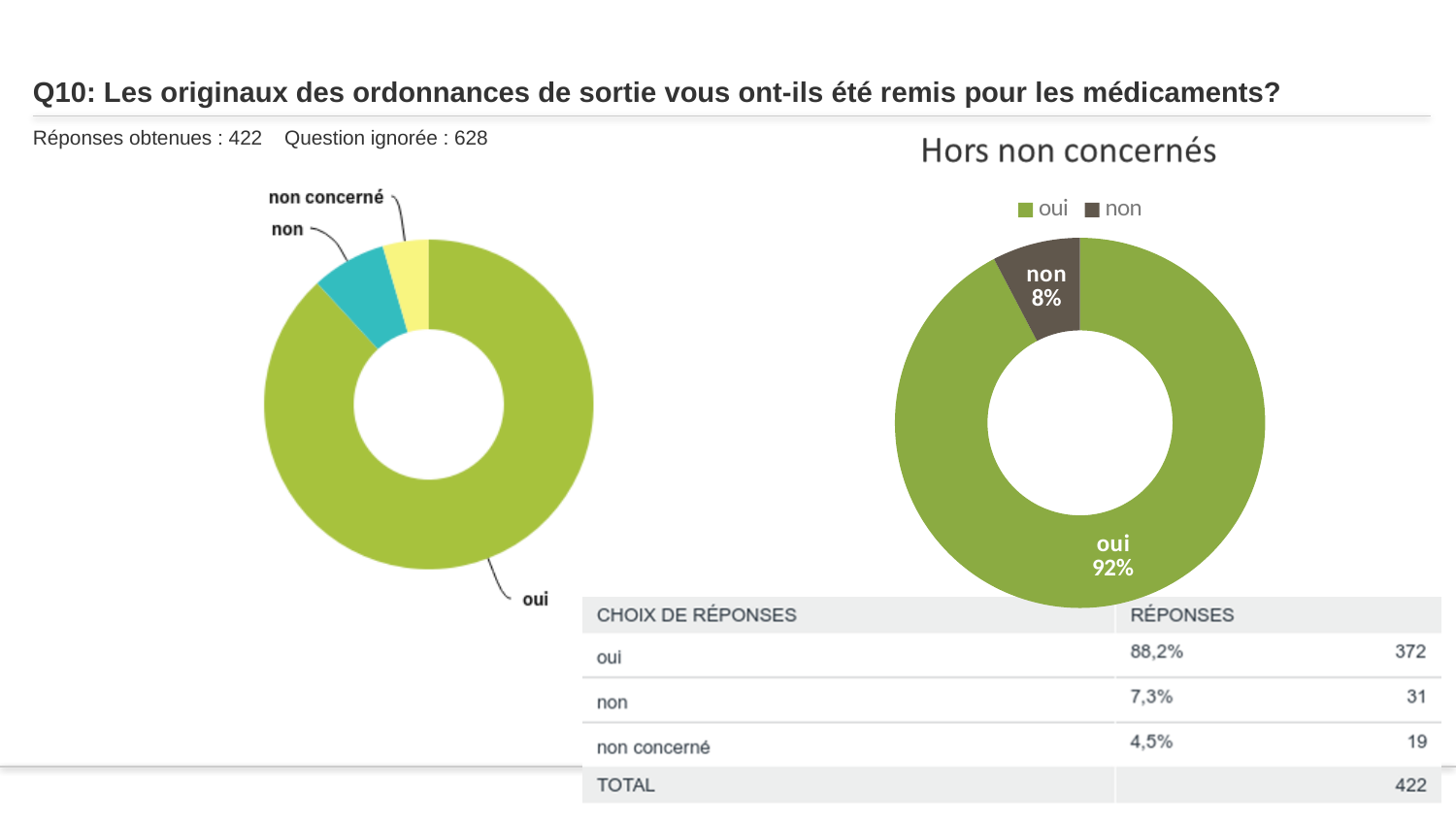
How many categories does the left-hand donut chart show? 3 In the left-hand donut chart, which category has the smallest slice? non concerné In the chart titled "Hors non concernés", what is the difference in percentage points between "oui" and "non"? 84 In the chart titled "Hors non concernés", what is the share for "oui"? 92% In the chart titled "Hors non concernés", which slice is the largest? oui In the left-hand donut chart, which category has the largest slice? oui In the left-hand donut chart, which slice is larger, "non" or "non concerné"? non In the chart titled "Hors non concernés", which slice is the smallest? non In the chart titled "Hors non concernés", what is the share for "non"? 8% In the chart titled "Hors non concernés", how many entries does the legend list? 2 What kind of chart is the chart titled "Hors non concernés"? pie chart (donut) What is the title of the right-hand donut chart? Hors non concernés